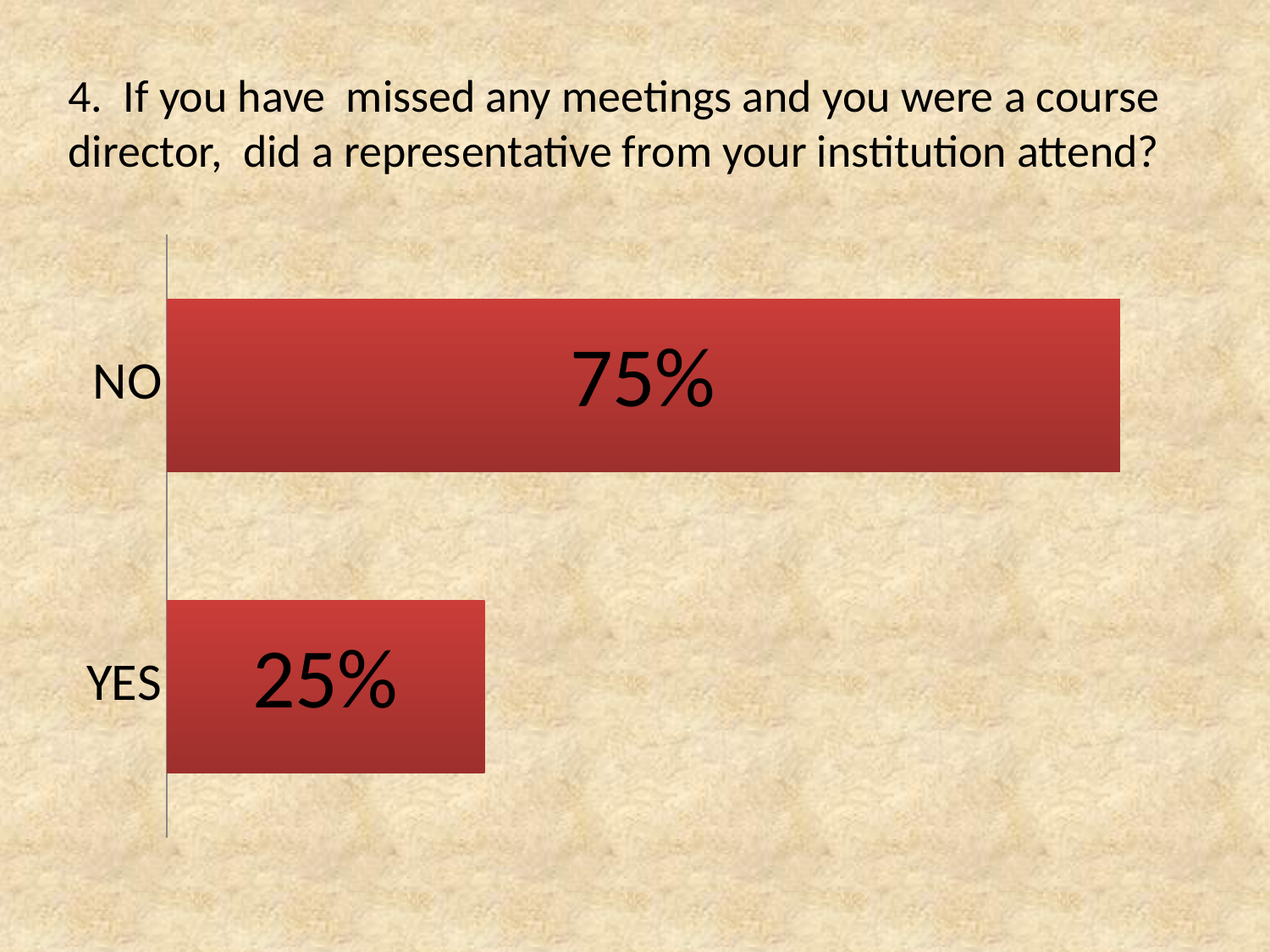
Which category has the highest value? NO What colour are the bars in the chart? Red What is the value for NO? 75% Are the bars in the chart horizontal or vertical? Horizontal What is the total of the values for NO and YES? 100% What is the difference between the values for NO and YES? 50% What is the value for YES? 25% Which is larger, the value for NO or the value for YES? NO Which category has the lowest value? YES What kind of chart is shown on the slide? Bar chart How many categories are shown in the chart? 2